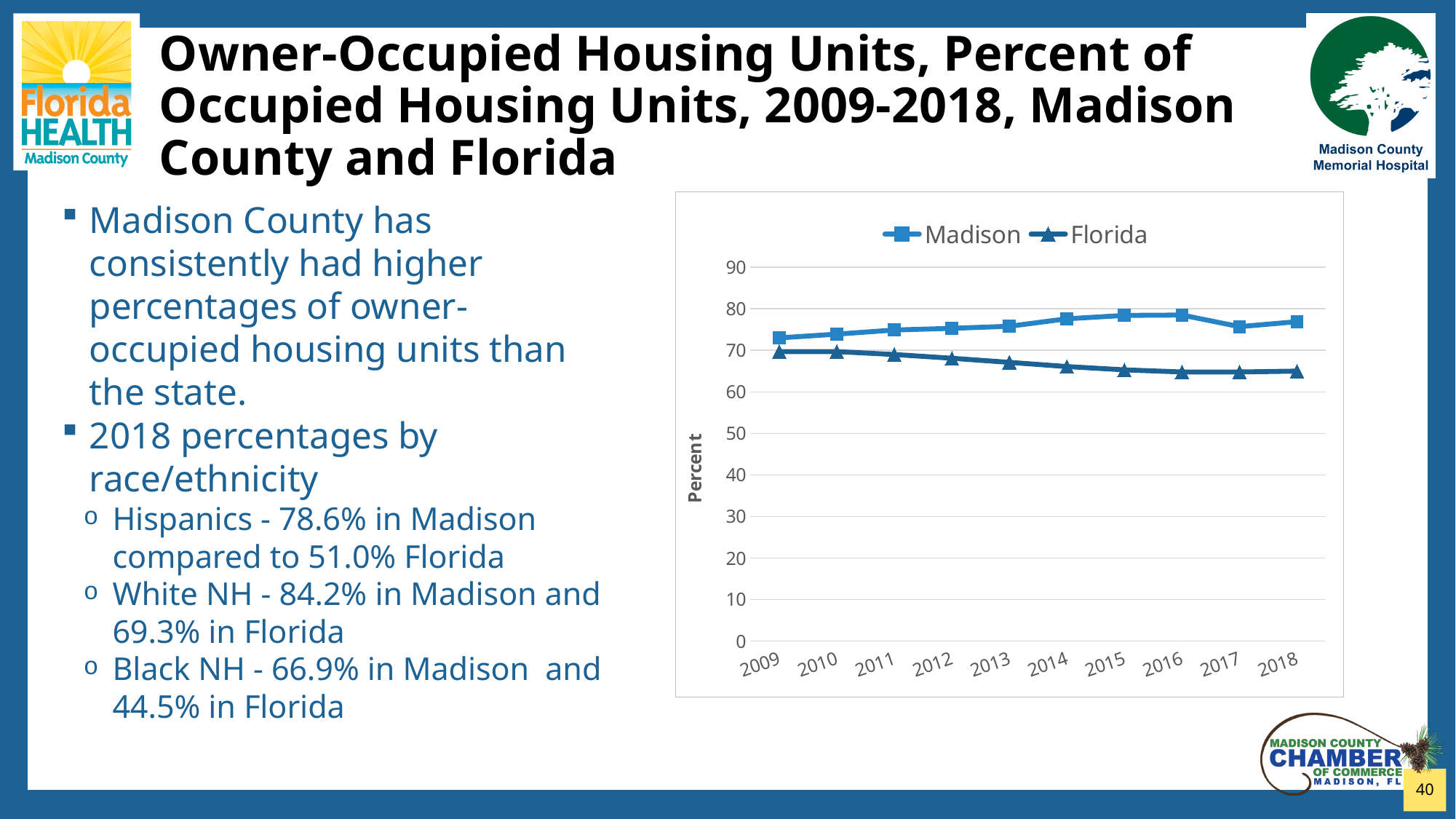
In 2018, which series has the higher value, Madison or Florida? Madison Is the value for Madison in 2016 greater or less than 80? less Does the Florida line rise or fall from 2009 to 2018? fall How many series does the chart legend list? 2 Which two series are listed in the chart legend? Madison and Florida What is the label on the vertical axis of the chart? Percent Is the value for Madison in 2016 greater or less than 70? greater How many years are plotted along the x axis of the chart? 10 Does the Madison line generally rise or fall from 2009 to 2016? rise What kind of chart is shown on the slide? line chart Is the value for Florida in 2015 greater or less than 60? greater